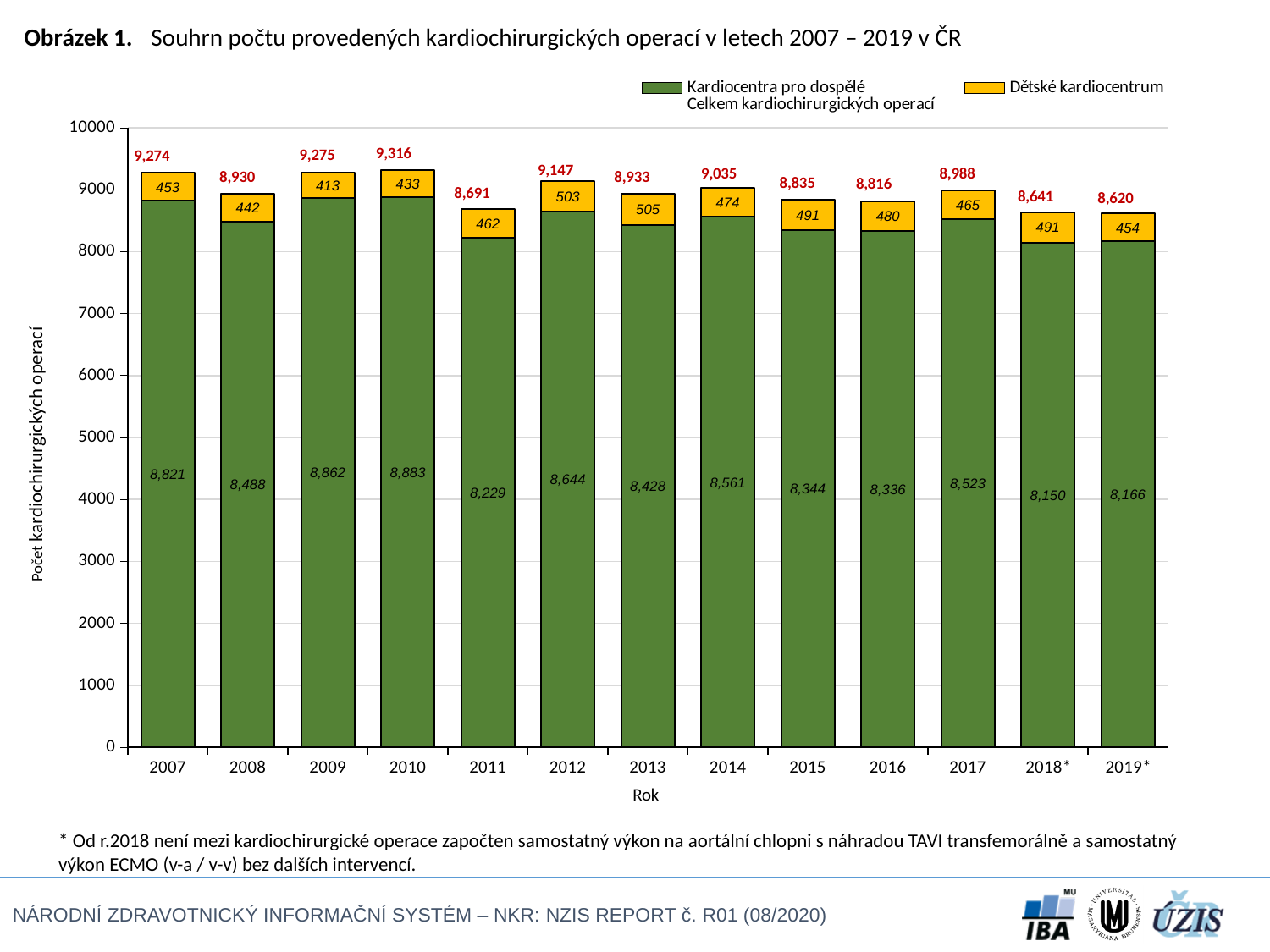
What is the total number of operations shown for 2010? 9,316 How many years are shown on the x axis? 13 What is the difference between the Kardiocentra pro dospělé values for 2010 and 2011? 654 Which year has the highest total number of cardiac surgery operations? 2010 What is the value for Dětské kardiocentrum in 2013? 505 How many series does the legend list? 3 Which is larger, the Dětské kardiocentrum value for 2012 or for 2009? 2012 Which colour represents Dětské kardiocentrum in the chart? Yellow Which year has the lowest total number of cardiac surgery operations? 2019* Is the total for 2018* greater or less than 9000? less What is the value for Kardiocentra pro dospělé in 2011? 8,229 What kind of chart is shown on the slide? Stacked bar chart